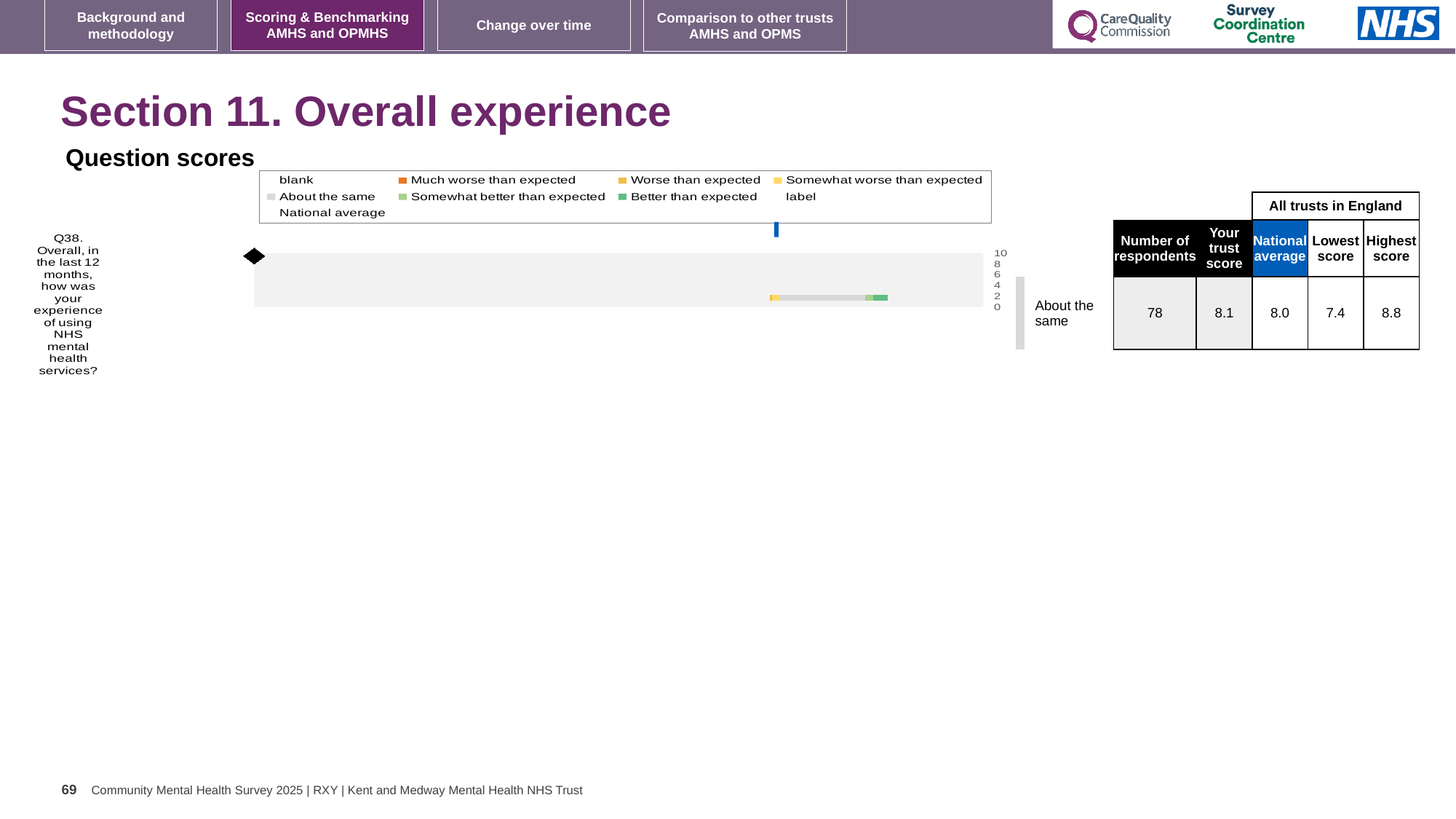
What benchmark category is shown next to the bar for Q38? About the same What is the trust's score for Q38? 8.1 What is the difference between the trust's score and the national average for Q38? 0.1 What kind of chart is used to show the Q38 question score? bar chart What is the national average score for Q38? 8.0 How many questions are plotted in the Question scores chart? 1 What is the lowest score among all trusts in England for Q38? 7.4 Which is larger for Q38, the trust's score or the national average? the trust's score What is the highest score among all trusts in England for Q38? 8.8 Which question is plotted in the Question scores chart? Q38. Overall, in the last 12 months, how was your experience of using NHS mental health services? How many respondents answered Q38? 78 What is the difference between the highest and lowest trust scores for Q38? 1.4